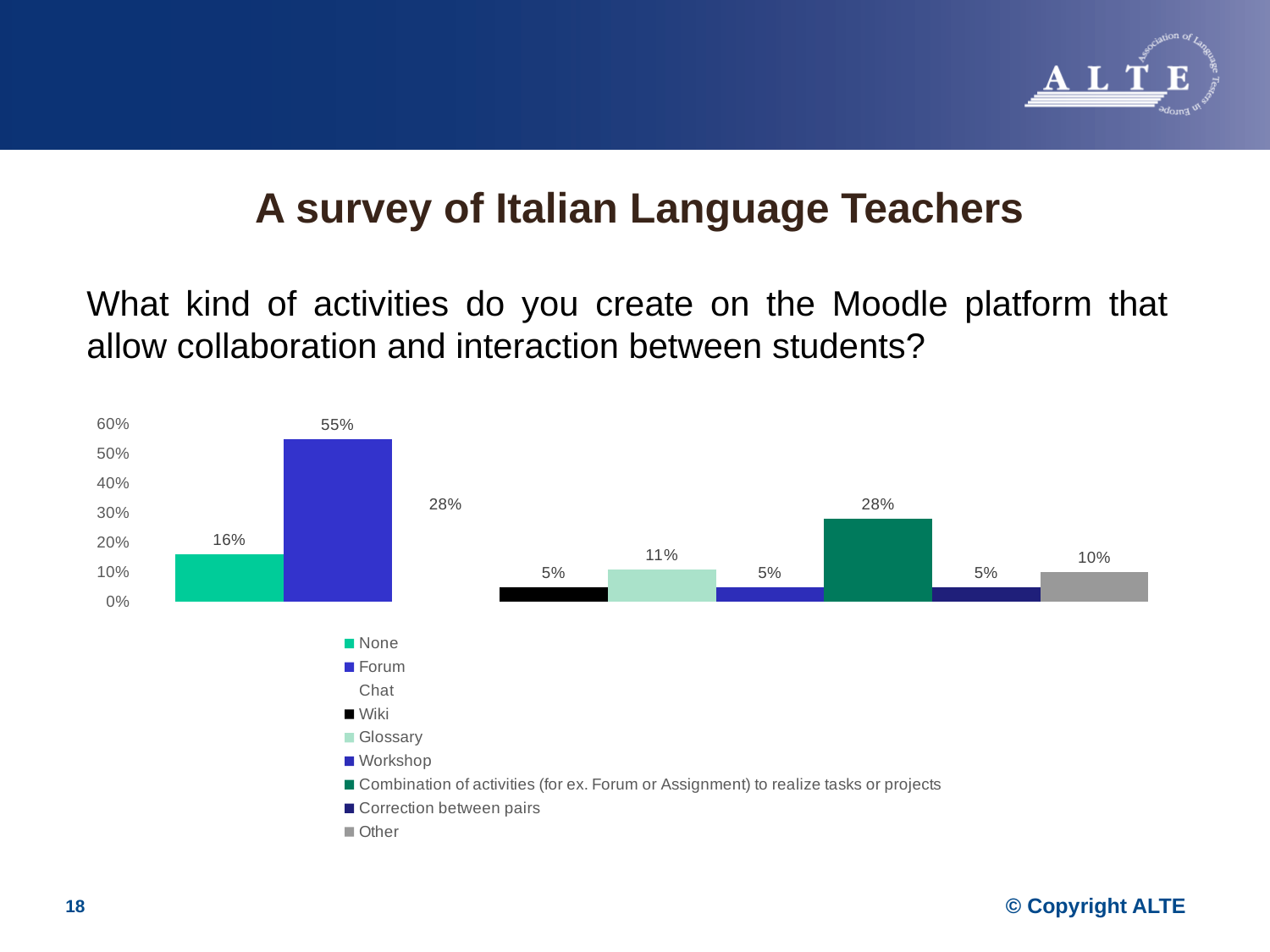
What percentage of teachers answered None? 16% What is the value for Combination of activities (for ex. Forum or Assignment) to realize tasks or projects? 28% What is the value for Glossary? 11% Which activity has the highest percentage? Forum What is the difference between the Forum value and the None value? 39% What percentage of teachers answered Forum? 55% What is the value for Wiki? 5% How many series does the legend list? 9 Is the value for Forum greater or less than 50%? greater What is the value for Other? 10% What kind of chart is shown on the slide? bar chart Which is larger, the value for Glossary or the value for Other? Glossary